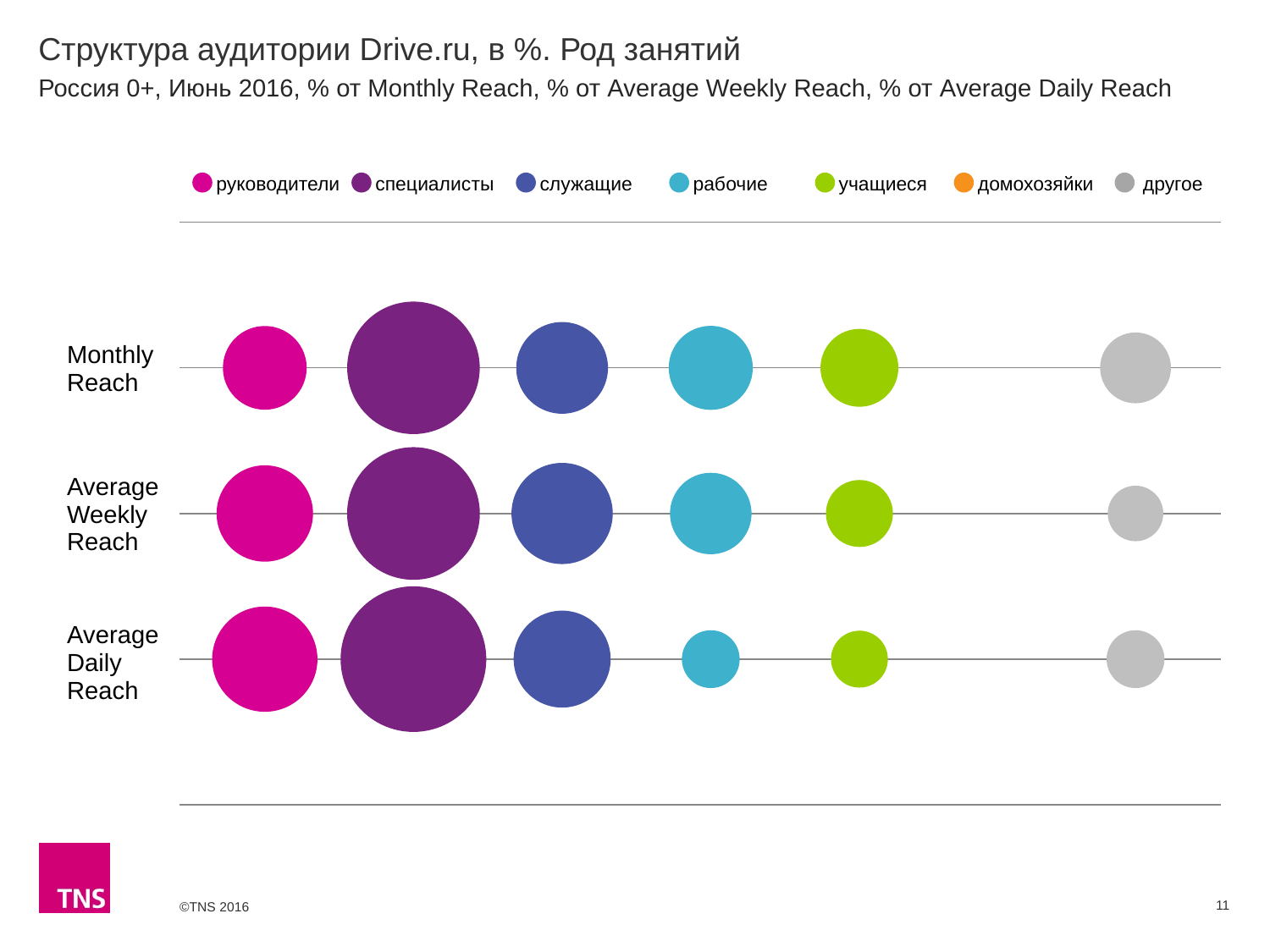
How many categories does the legend list? 7 What kind of chart is shown on the slide? bubble chart Which occupation group has the largest bubble in the Monthly Reach row? специалисты For руководители, which row has the larger bubble: Monthly Reach or Average Daily Reach? Average Daily Reach For рабочие, which row has the larger bubble: Monthly Reach or Average Daily Reach? Monthly Reach What is the title of the slide? Структура аудитории Drive.ru, в %. Род занятий Which occupation group has the largest bubble in the Average Daily Reach row? специалисты In the Monthly Reach row, which bubble is larger: руководители or специалисты? специалисты Which legend category has no visible bubble in any row of the chart? домохозяйки How many reach rows (Monthly, Weekly, Daily) are plotted on the chart? 3